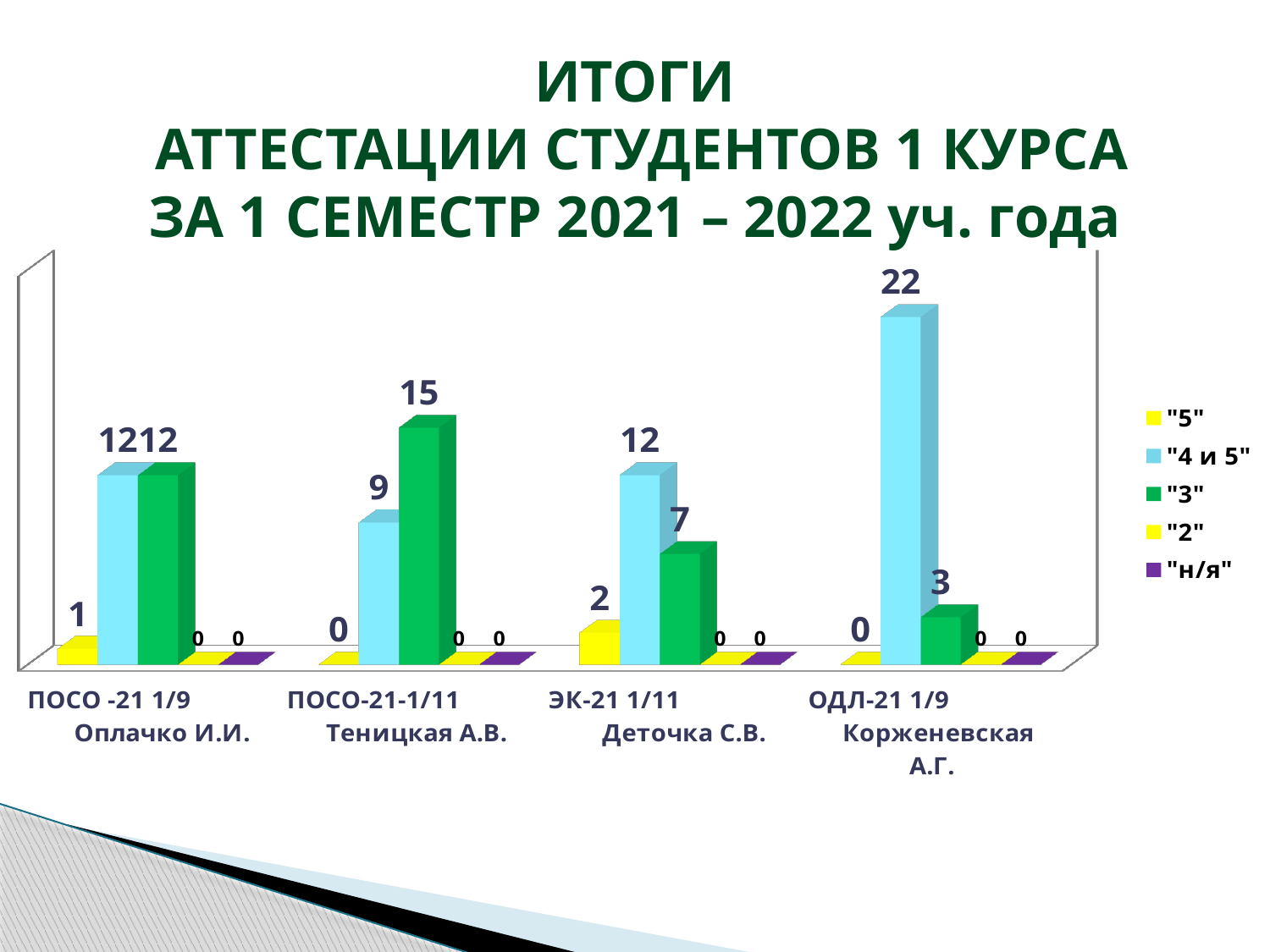
What is the value of "4 и 5" for ОДЛ-21 1/9 (Корженевская А.Г.)? 22 What is the difference between the "3" value for ПОСО-21-1/11 and the "3" value for ЭК-21 1/11? 8 What colour are the bars for the "4 и 5" series? light blue Which is larger for ЭК-21 1/11: the "4 и 5" value or the "3" value? "4 и 5" What is the value of "5" for ЭК-21 1/11 (Деточка С.В.)? 2 How many groups (categories) are shown along the x axis? 4 How many series does the legend list? 5 Which group has the lowest value for "3"? ОДЛ-21 1/9 What is the value of "3" for ПОСО-21-1/11 (Теницкая А.В.)? 15 What is the value of "н/я" for ПОСО -21 1/9 (Оплачко И.И.)? 0 What kind of chart is shown on the slide? bar chart Which group has the highest value for "4 и 5"? ОДЛ-21 1/9